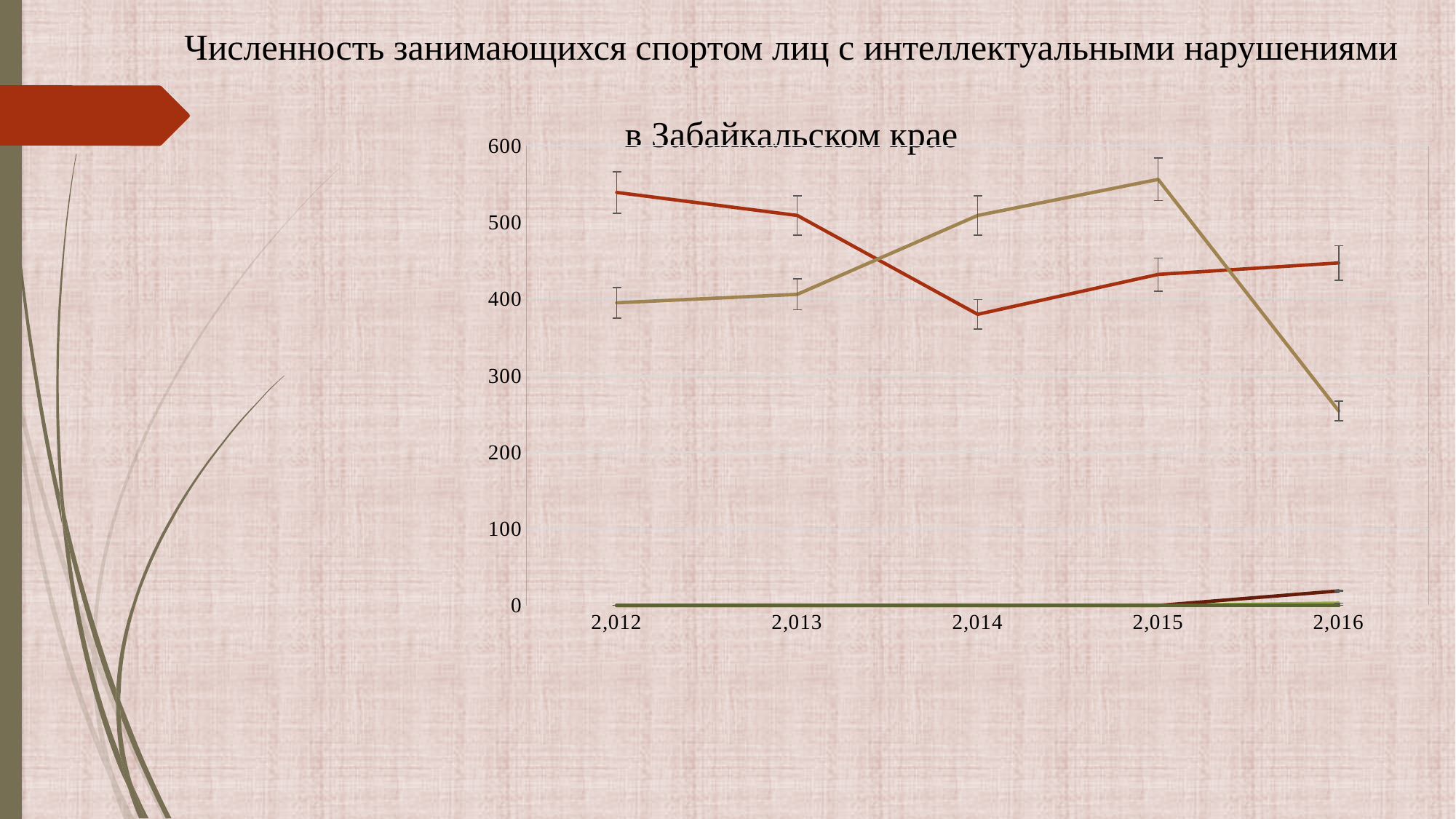
In which year does the tan (light brown) line reach its highest value? 2,015 In which year does the red line reach its highest value? 2,012 In 2,016, which line has the higher value, the red line or the tan (light brown) line? the red line How many years are shown along the x axis of the chart? 5 What kind of chart is shown on the slide? line chart Does the tan (light brown) line rise or fall between 2,015 and 2,016? fall Is the value of the tan (light brown) line in 2,015 greater or less than 500? greater In which year does the red line reach its lowest value? 2,014 Is the value of the red line in 2,012 greater or less than 500? greater What is the title of the chart on the slide? Численность занимающихся спортом лиц с интеллектуальными нарушениями в Забайкальском крае Is the value of the tan (light brown) line in 2,016 greater or less than 300? less In which year does the tan (light brown) line reach its lowest value? 2,016